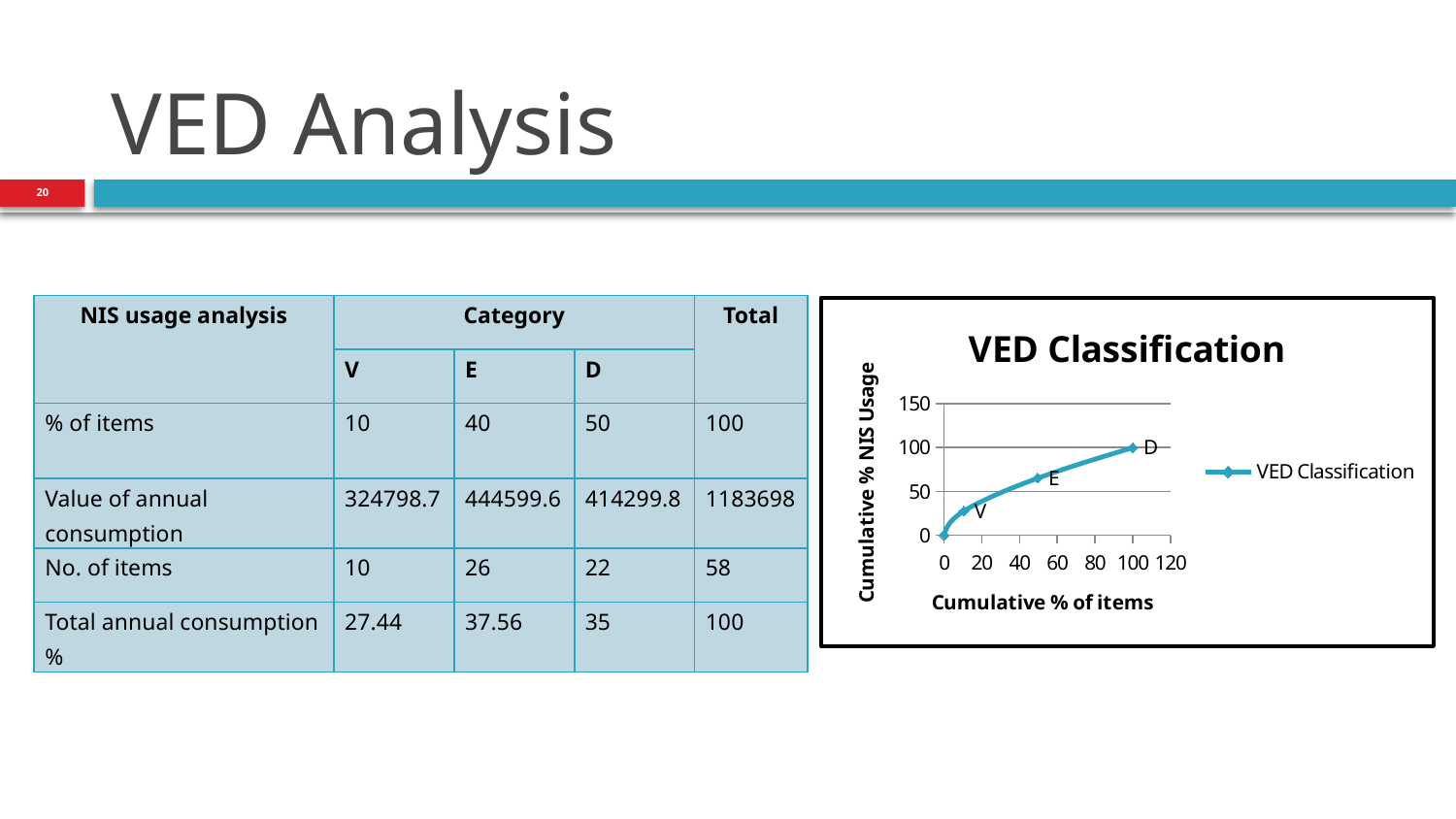
Does the VED Classification line rise or fall as cumulative % of items increases? rises How many series does the legend of the VED Classification chart list? 1 What kind of chart is the VED Classification chart? line chart What is the title of the chart on the slide? VED Classification In the VED Classification chart, which point has a higher cumulative % NIS usage, V or E? E In the VED Classification chart, which labeled point has the highest cumulative % NIS usage? D In the VED Classification chart, is the cumulative % NIS usage at point E greater or less than 50? greater How many labeled points (V, E, D) are marked on the VED Classification line? 3 In the VED Classification chart, is the cumulative % NIS usage at point D greater or less than 150? less What is the label on the y axis of the VED Classification chart? Cumulative % NIS Usage In the VED Classification chart, is the cumulative % NIS usage at point V greater or less than 50? less In the VED Classification chart, which labeled point has the lowest cumulative % NIS usage? V